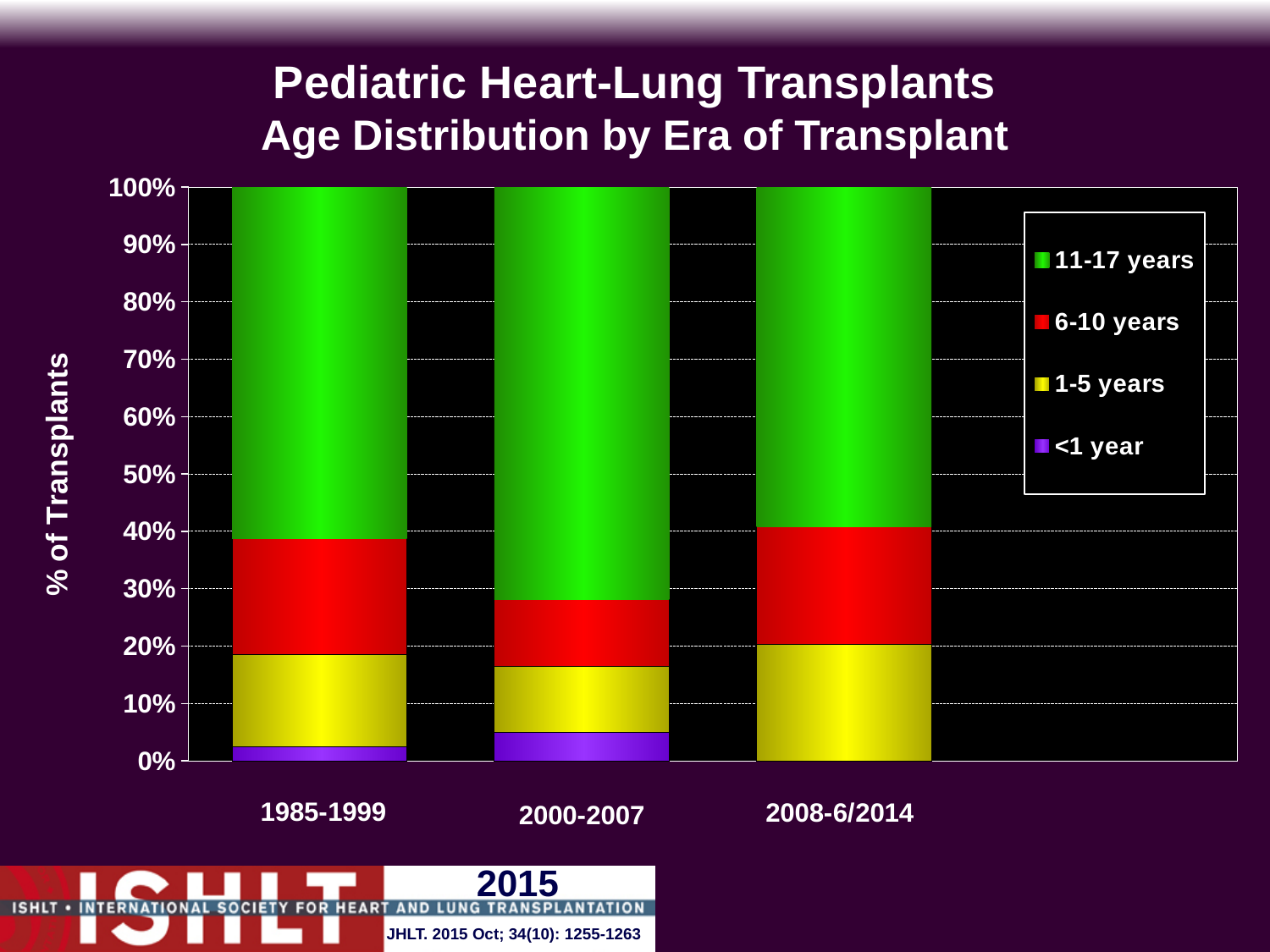
What is the label on the y axis? % of Transplants Is the 6-10 years share for 1985-1999 greater or less than 10%? greater Is the <1 year share for 2000-2007 greater or less than 10%? less Which era has the largest 11-17 years segment? 2000-2007 How many transplant eras are shown on the x axis? 3 What kind of chart is shown on the slide? Stacked bar chart Which era shows no visible <1 year segment? 2008-6/2014 Which era has the smallest 6-10 years segment? 2000-2007 Is the 1-5 years segment larger in 2008-6/2014 or in 2000-2007? 2008-6/2014 Is the 11-17 years share for 2000-2007 greater or less than 60%? greater What is the total height of the stacked bar for 1985-1999? 100% How many age groups does the legend list? 4